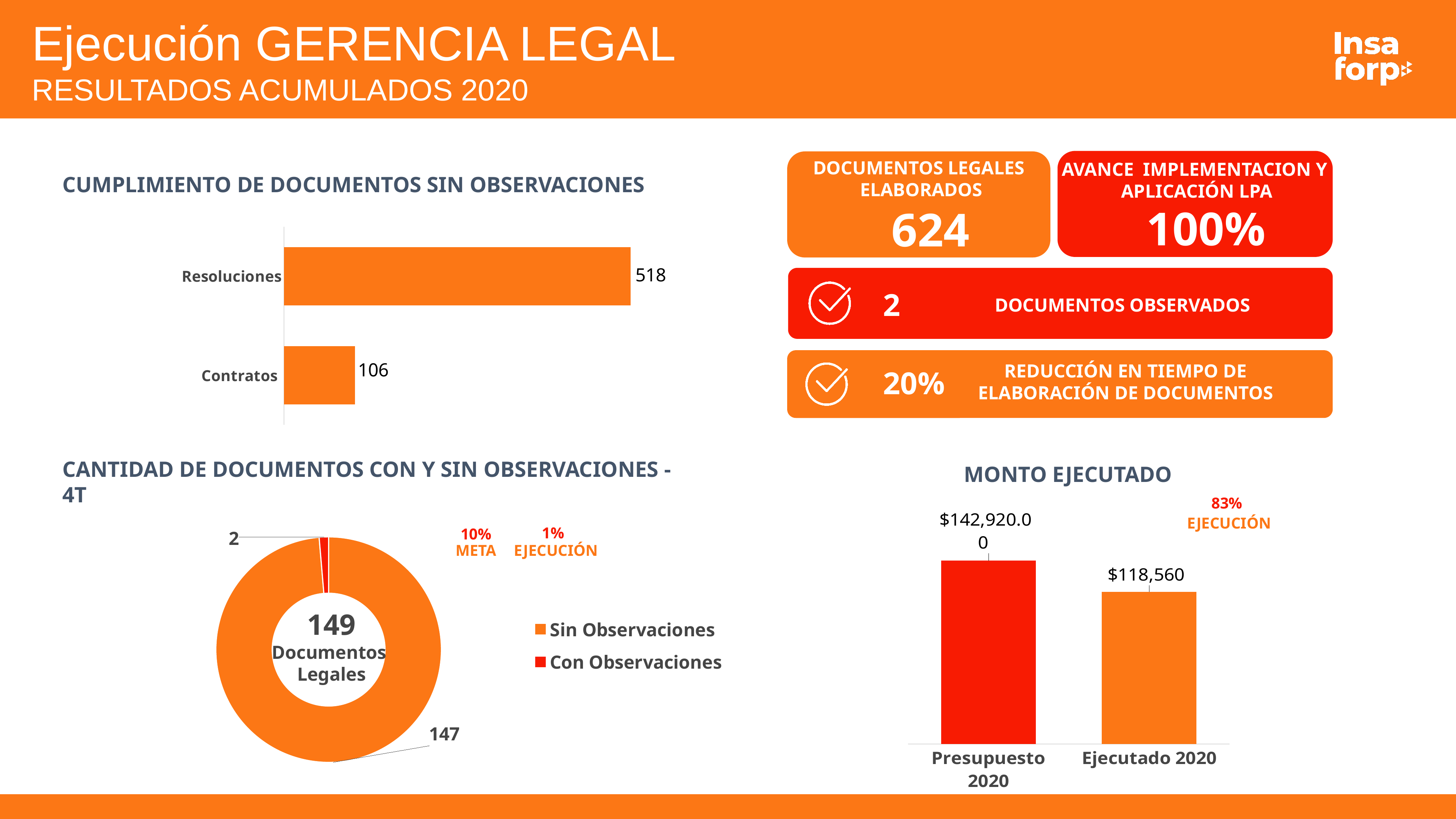
In the chart 'CANTIDAD DE DOCUMENTOS CON Y SIN OBSERVACIONES - 4T', what is the value for Sin Observaciones? 147 In the chart 'MONTO EJECUTADO', what is the value for Ejecutado 2020? $118,560 In the chart 'CUMPLIMIENTO DE DOCUMENTOS SIN OBSERVACIONES', which category has the highest value? Resoluciones In the chart 'CANTIDAD DE DOCUMENTOS CON Y SIN OBSERVACIONES - 4T', how many entries does the legend list? 2 In the chart 'MONTO EJECUTADO', how many bars are plotted? 2 In the chart 'CUMPLIMIENTO DE DOCUMENTOS SIN OBSERVACIONES', what is the difference between Resoluciones and Contratos? 412 In the chart 'CANTIDAD DE DOCUMENTOS CON Y SIN OBSERVACIONES - 4T', what total number of documents is shown in the centre of the donut? 149 In the chart 'CUMPLIMIENTO DE DOCUMENTOS SIN OBSERVACIONES', what is the value for Contratos? 106 In the chart 'CANTIDAD DE DOCUMENTOS CON Y SIN OBSERVACIONES - 4T', what is the value for Con Observaciones? 2 In the chart 'MONTO EJECUTADO', which of the two bars is larger, Presupuesto 2020 or Ejecutado 2020? Presupuesto 2020 What kind of chart is 'CUMPLIMIENTO DE DOCUMENTOS SIN OBSERVACIONES'? Bar chart In the chart 'CUMPLIMIENTO DE DOCUMENTOS SIN OBSERVACIONES', what is the value for Resoluciones? 518